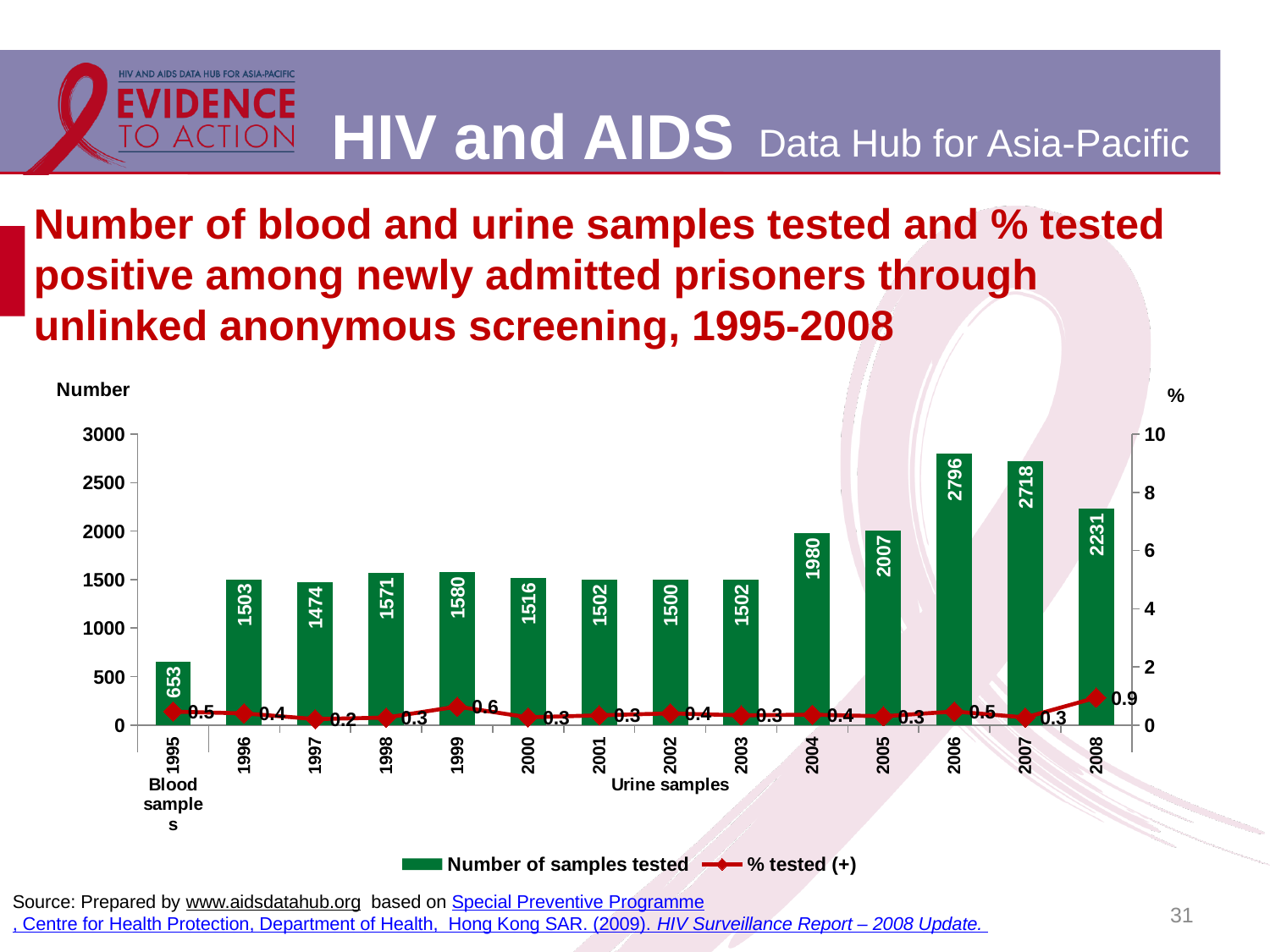
How many years are shown on the x axis? 14 What kind of chart is shown on the slide? Combined bar and line chart Which year had the lowest % tested positive? 1997 How many series does the legend list? 2 Which year had more samples tested, 2004 or 2008? 2008 Which year had the lowest number of samples tested? 1995 How many samples were tested in 1995? 653 What was the % tested positive in 2008? 0.9 Which year had the highest number of samples tested? 2006 What is the difference in the number of samples tested between 2006 and 2007? 78 Which series is shown by the green bars? Number of samples tested How many samples were tested in 2006? 2796